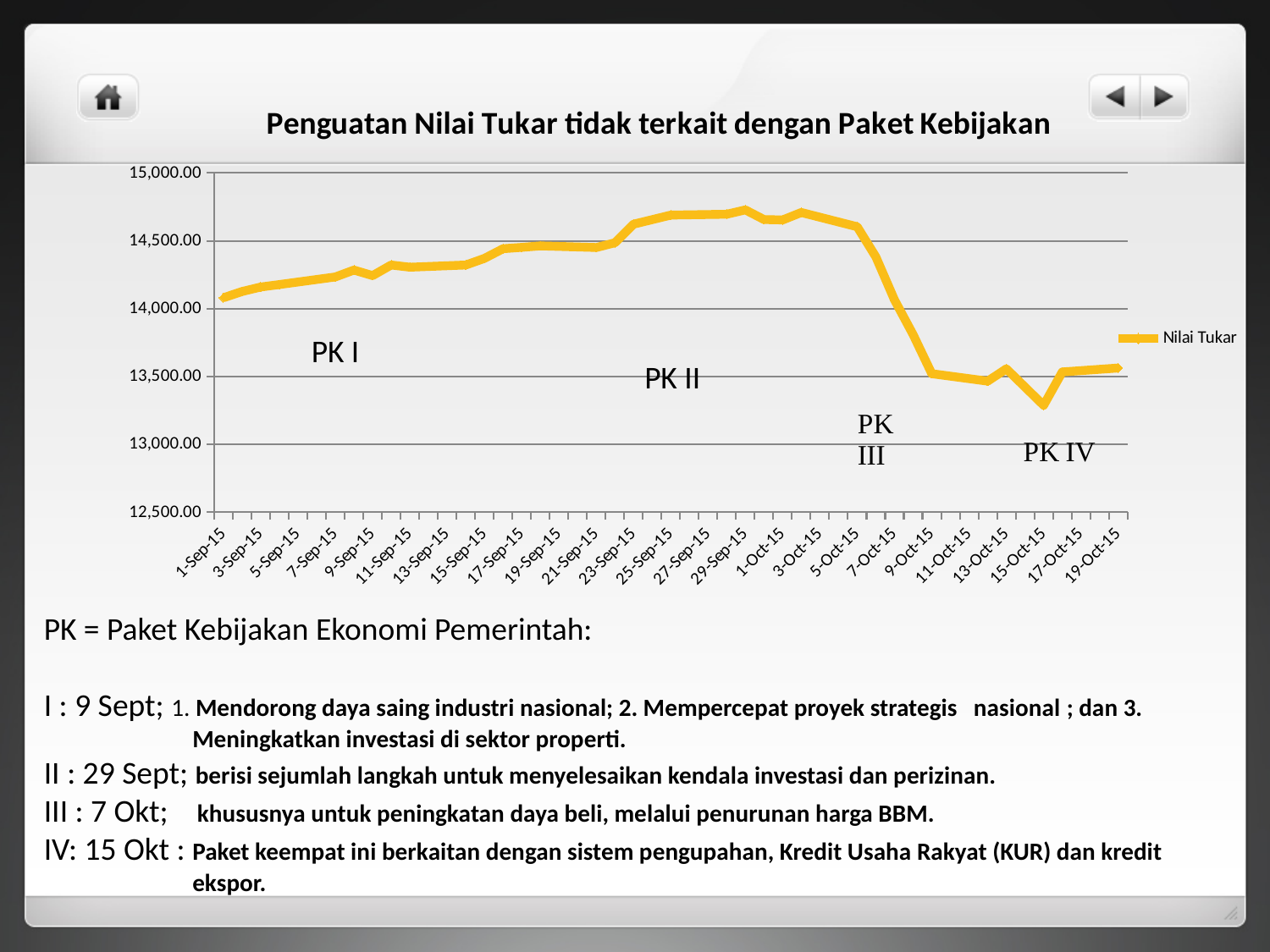
Is the value for 29-Sep-15 greater or less than 14,500.00? greater Is the value for 15-Oct-15 greater or less than 13,500.00? less What is the title of the chart? Penguatan Nilai Tukar tidak terkait dengan Paket Kebijakan What is the name of the series shown in the legend? Nilai Tukar On which date does the Nilai Tukar line reach its lowest point? 15-Oct-15 Is the value for 19-Oct-15 greater or less than 14,000.00? less How many series does the legend list? 1 Does the Nilai Tukar line rise or fall between 5-Oct-15 and 9-Oct-15? fall Which date has the higher Nilai Tukar value, 1-Sep-15 or 19-Oct-15? 1-Sep-15 Does the Nilai Tukar line generally rise or fall between 1-Sep-15 and 29-Sep-15? rise What kind of chart is shown on the slide? line chart